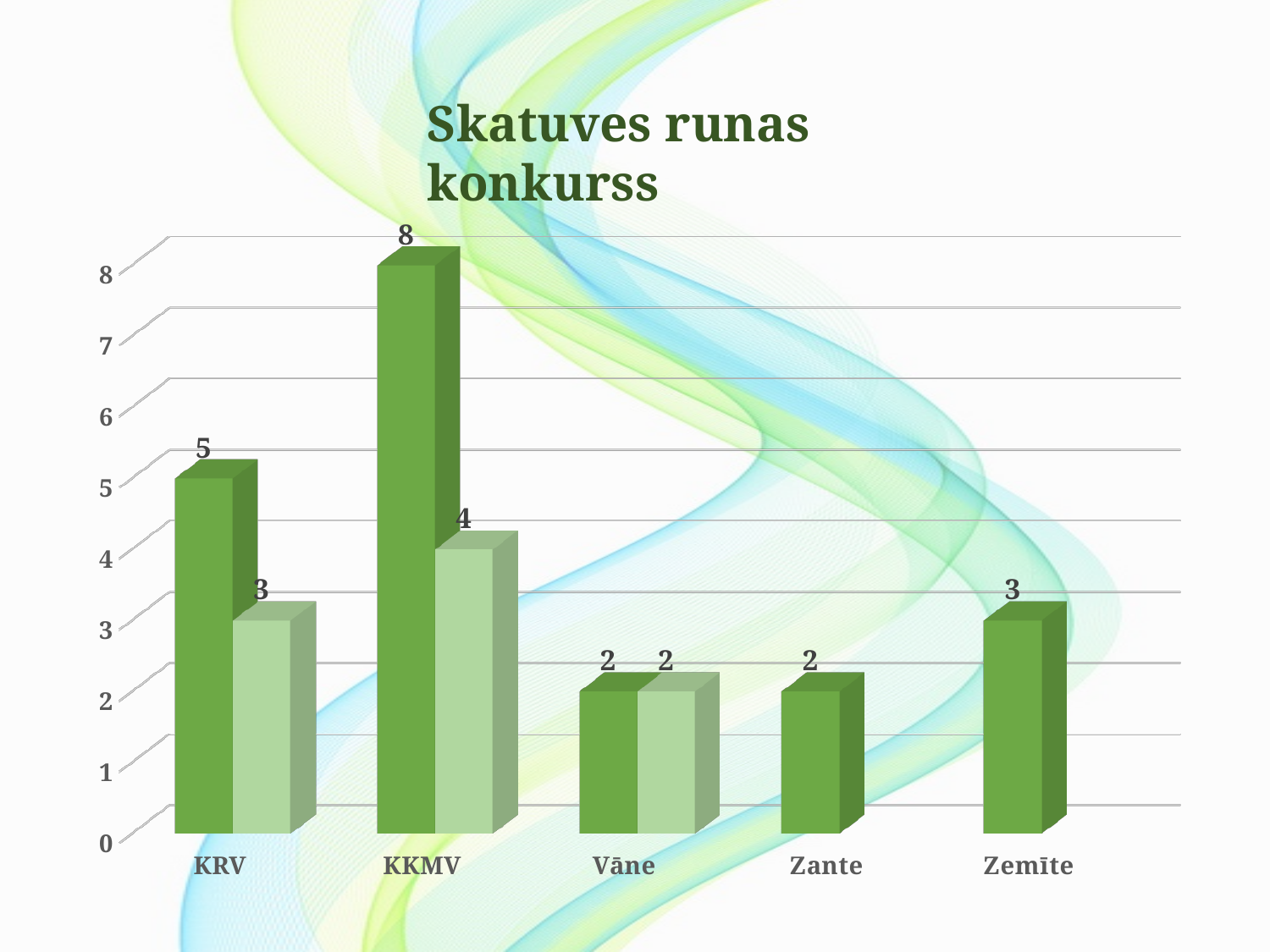
What is the value of the dark green bar for Zemīte? 3 What type of chart is shown on the slide? bar chart What is the difference between the dark green and light green bars for KKMV? 4 How many categories are shown on the x axis? 5 What is the value of the dark green bar for KKMV? 8 What is the value of the light green bar for KRV? 3 Which category has the highest dark green bar? KKMV Which categories have only a single bar? Zante and Zemīte What is the difference between the dark green bar for KKMV and the dark green bar for KRV? 3 What is the value of the dark green bar for Zante? 2 What is the title of the chart? Skatuves runas konkurss Which is larger, the dark green bar for KRV or the dark green bar for Zemīte? KRV